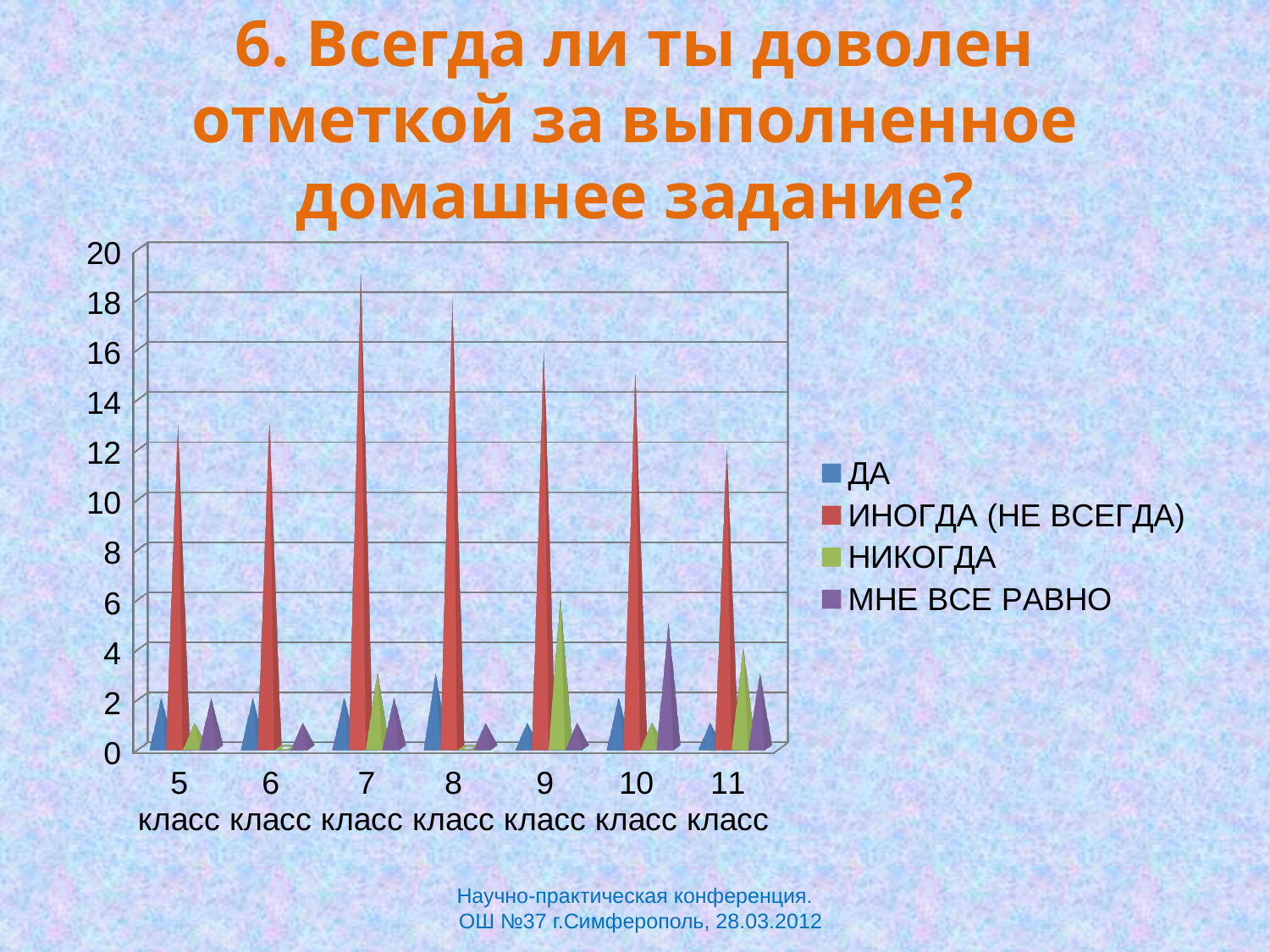
In 10 класс, which is larger: МНЕ ВСЕ РАВНО or НИКОГДА? МНЕ ВСЕ РАВНО What colour represents the series ИНОГДА (НЕ ВСЕГДА) in the legend? red Which series has the highest value in every class? ИНОГДА (НЕ ВСЕГДА) Which class has the highest value for МНЕ ВСЕ РАВНО? 10 класс Is the value of ДА for 8 класс greater or less than 4? less Is the value of ИНОГДА (НЕ ВСЕГДА) for 7 класс greater or less than 16? greater What kind of chart is shown on the slide? bar chart How many series does the legend list? 4 Is the value of НИКОГДА for 9 класс greater or less than 4? greater Which class has the highest value for НИКОГДА? 9 класс How many classes (categories) are shown on the x axis? 7